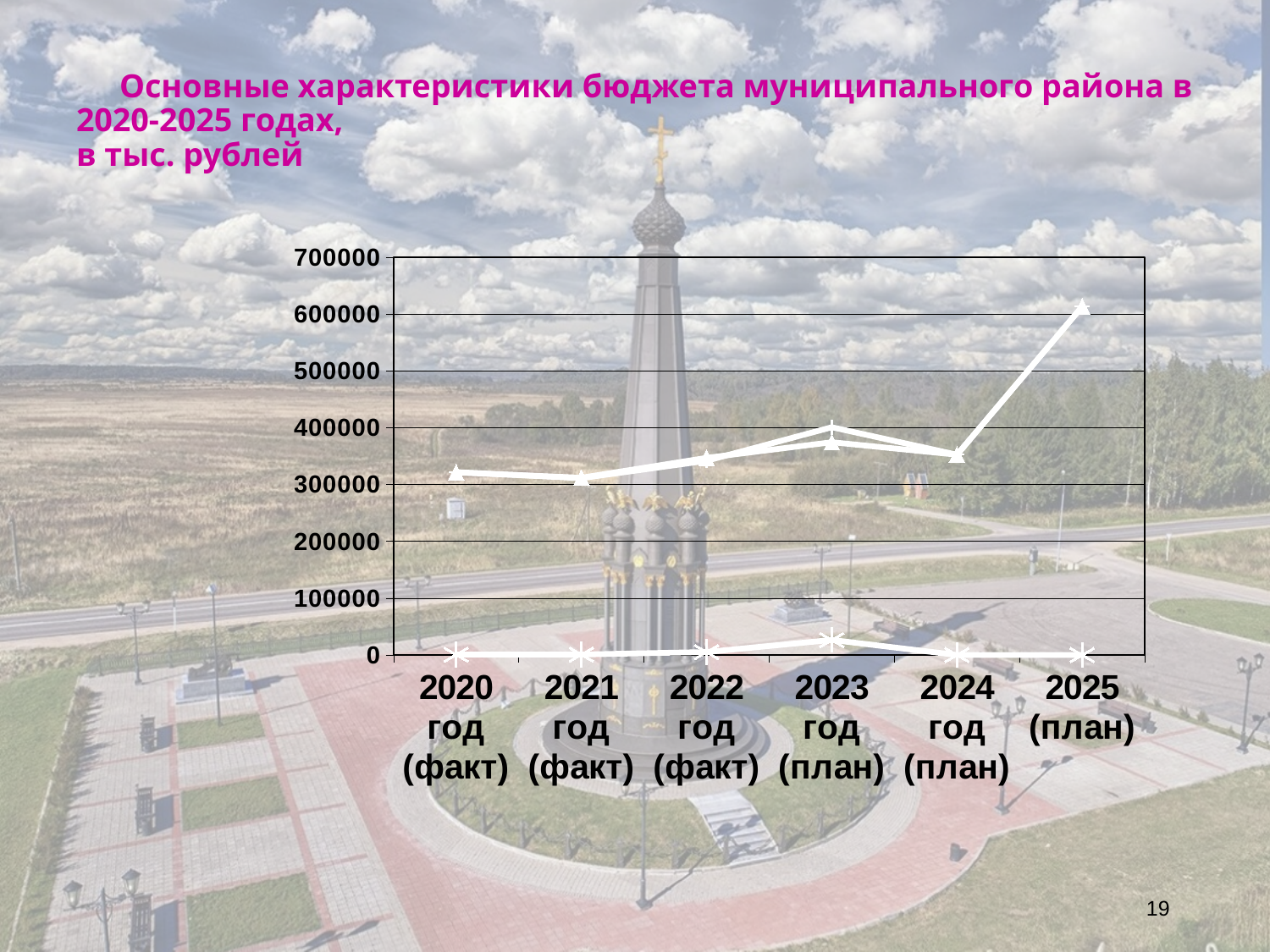
Is the value of the asterisk-marker line for 2023 год (план) greater or less than 100000? less In which year does the triangle-marker line reach its highest value? 2025 (план) For the plus-marker line, which is larger: the value for 2021 год (факт) or for 2023 год (план)? 2023 год (план) Is the value of the triangle-marker line for 2025 год (план) greater or less than 500000? greater In what units are the values on the slide expressed, according to the title? тыс. рублей How many year categories are shown on the x axis of the chart? 6 What is the highest tick value shown on the y axis of the chart? 700000 For the triangle-marker line, which is larger: the value for 2024 год (план) or for 2025 год (план)? 2025 (план) Does the triangle-marker line rise or fall from 2024 год (план) to 2025 год (план)? rise How many lines are plotted on the chart? 3 Is the value of the triangle-marker line for 2020 год (факт) greater or less than 400000? less What kind of chart is shown on the slide? line chart